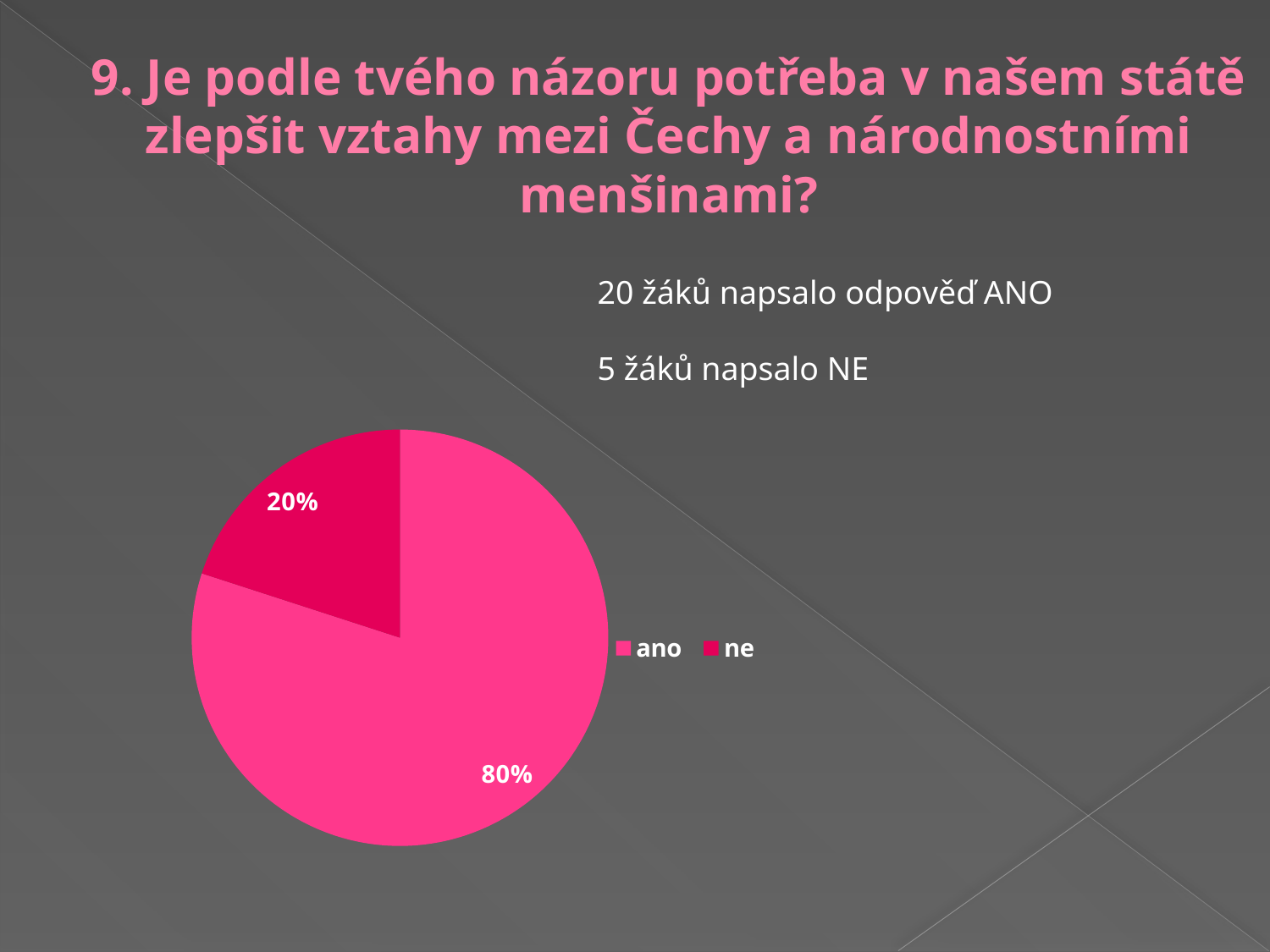
What share of the pie does the "ano" slice represent? 80% What is the difference in percentage points between the "ano" and "ne" slices? 60 What are the two legend entries of the pie chart? ano, ne Which slice of the pie is the smallest? ne Which is larger, the "ano" slice or the "ne" slice? ano Which legend entry is shown in the darker pink colour? ne What share of the pie does the "ne" slice represent? 20% What kind of chart is shown on the slide? pie chart How many entries does the legend list? 2 Which slice of the pie is the largest? ano How many slices does the pie chart have? 2